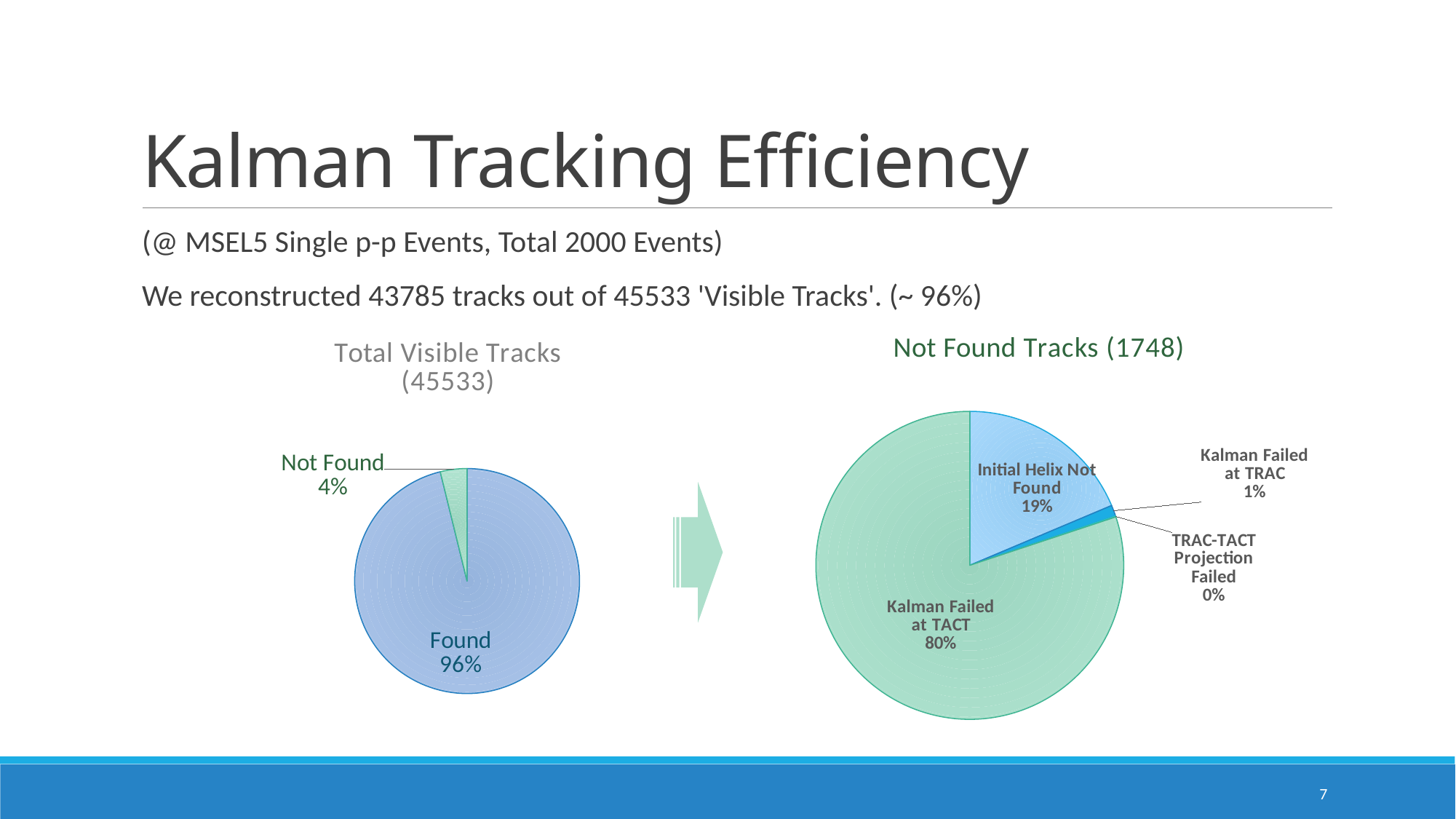
In the 'Not Found Tracks (1748)' chart, what share is labelled 'Kalman Failed at TACT'? 80% In the 'Total Visible Tracks (45533)' chart, what share of the pie is labelled 'Not Found'? 4% In the 'Not Found Tracks (1748)' chart, what share is labelled 'Initial Helix Not Found'? 19% In the 'Total Visible Tracks (45533)' chart, what is the difference in percentage points between 'Found' and 'Not Found'? 92 In the 'Not Found Tracks (1748)' chart, which category has the smallest slice? TRAC-TACT Projection Failed In the 'Not Found Tracks (1748)' chart, how many categories are shown? 4 What type of chart is the 'Total Visible Tracks (45533)' chart? Pie chart In the 'Not Found Tracks (1748)' chart, which category has the largest slice? Kalman Failed at TACT In the 'Not Found Tracks (1748)' chart, which is larger, 'Initial Helix Not Found' or 'Kalman Failed at TRAC'? Initial Helix Not Found